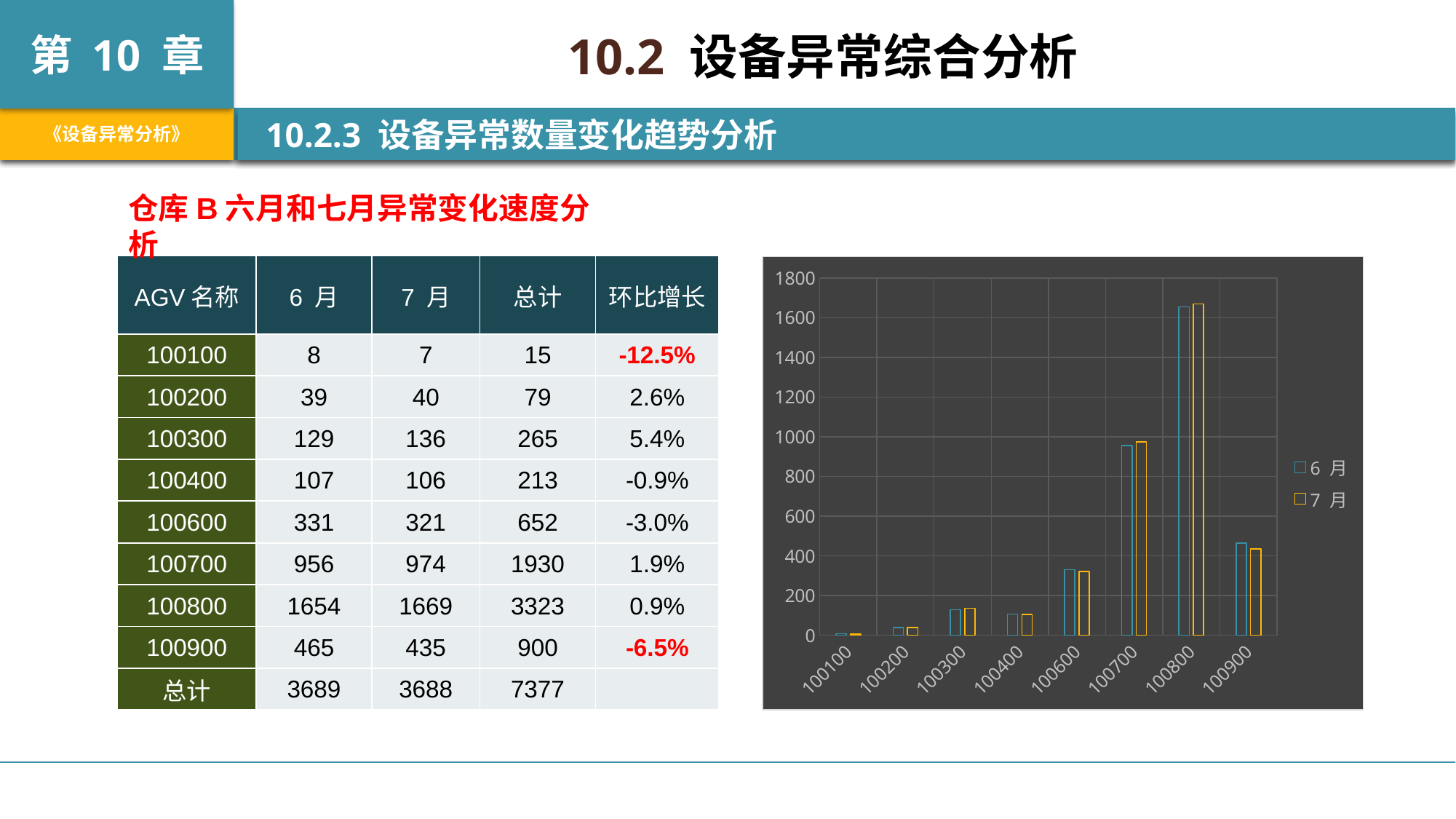
What kind of chart is shown on the slide? bar chart For AGV 100900, which series has the taller bar, 6 月 or 7 月? 6 月 Is the 7 月 value for AGV 100900 greater or less than 600? less Is the 6 月 value for AGV 100800 greater or less than 1600? greater Which AGV has the highest bars in the chart? 100800 How many AGV categories are plotted along the x axis of the chart? 8 Which is taller in the chart, the 6 月 bar for 100600 or the 6 月 bar for 100900? 100900 Is the 6 月 value for AGV 100700 greater or less than 800? greater According to the table on the slide, what is the 7 月 value for AGV 100800? 1669 What are the two legend entries of the chart? 6 月 and 7 月 How many series does the chart legend list? 2 Which AGV has the lowest bars in the chart? 100100